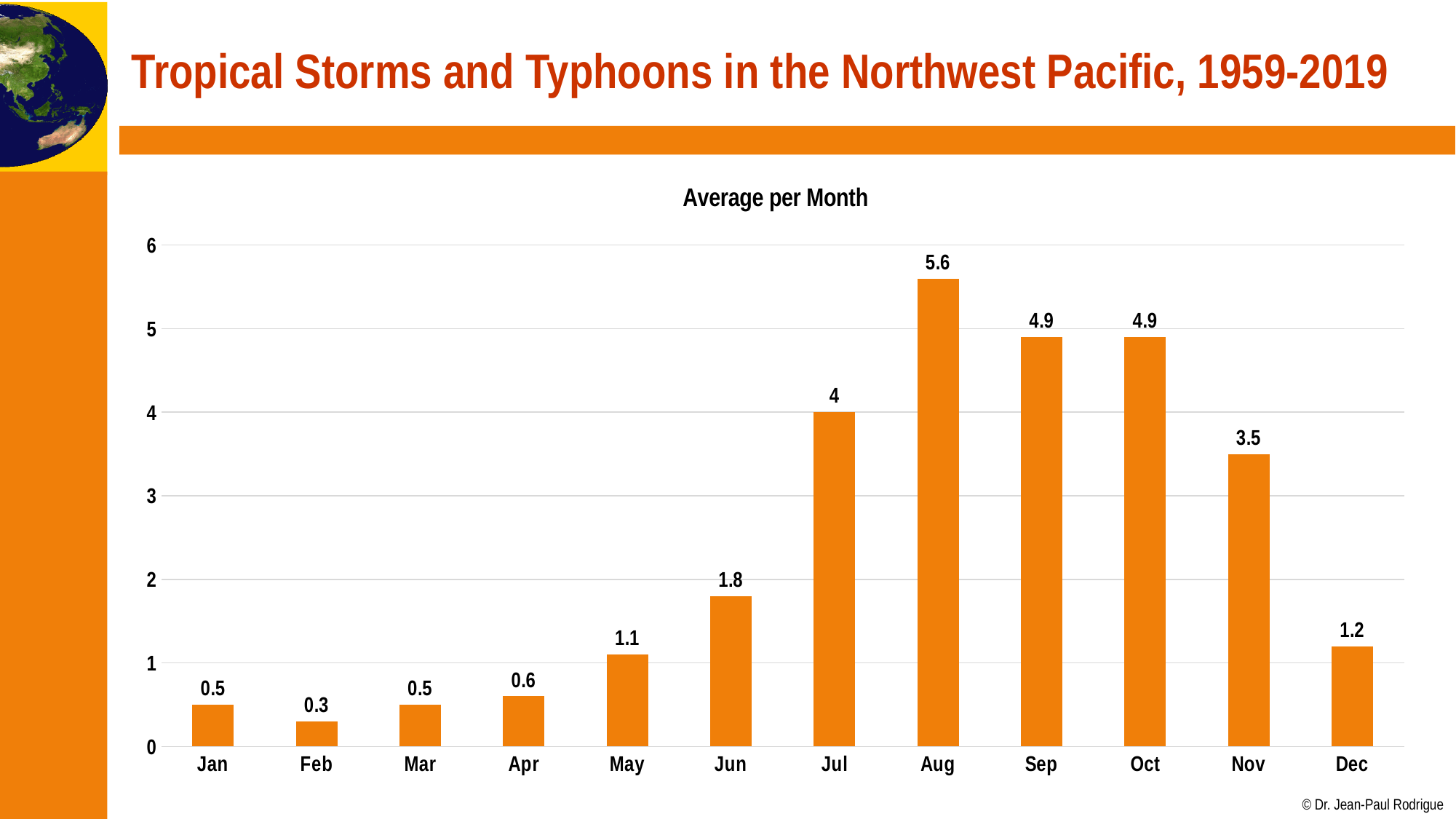
What kind of chart is shown on the slide? bar chart What is the value shown for February? 0.3 What is the title of the chart? Average per Month What is the difference between the values for June and December? 0.6 Is the value for September greater or less than 4? greater How many months are shown on the x axis? 12 Which is larger, the value for November or the value for July? Jul Which month has the highest average? Aug What is the average number of tropical storms and typhoons per month in August? 5.6 What is the value shown for November? 3.5 What is the difference between the values for August and July? 1.6 Which month has the lowest average? Feb